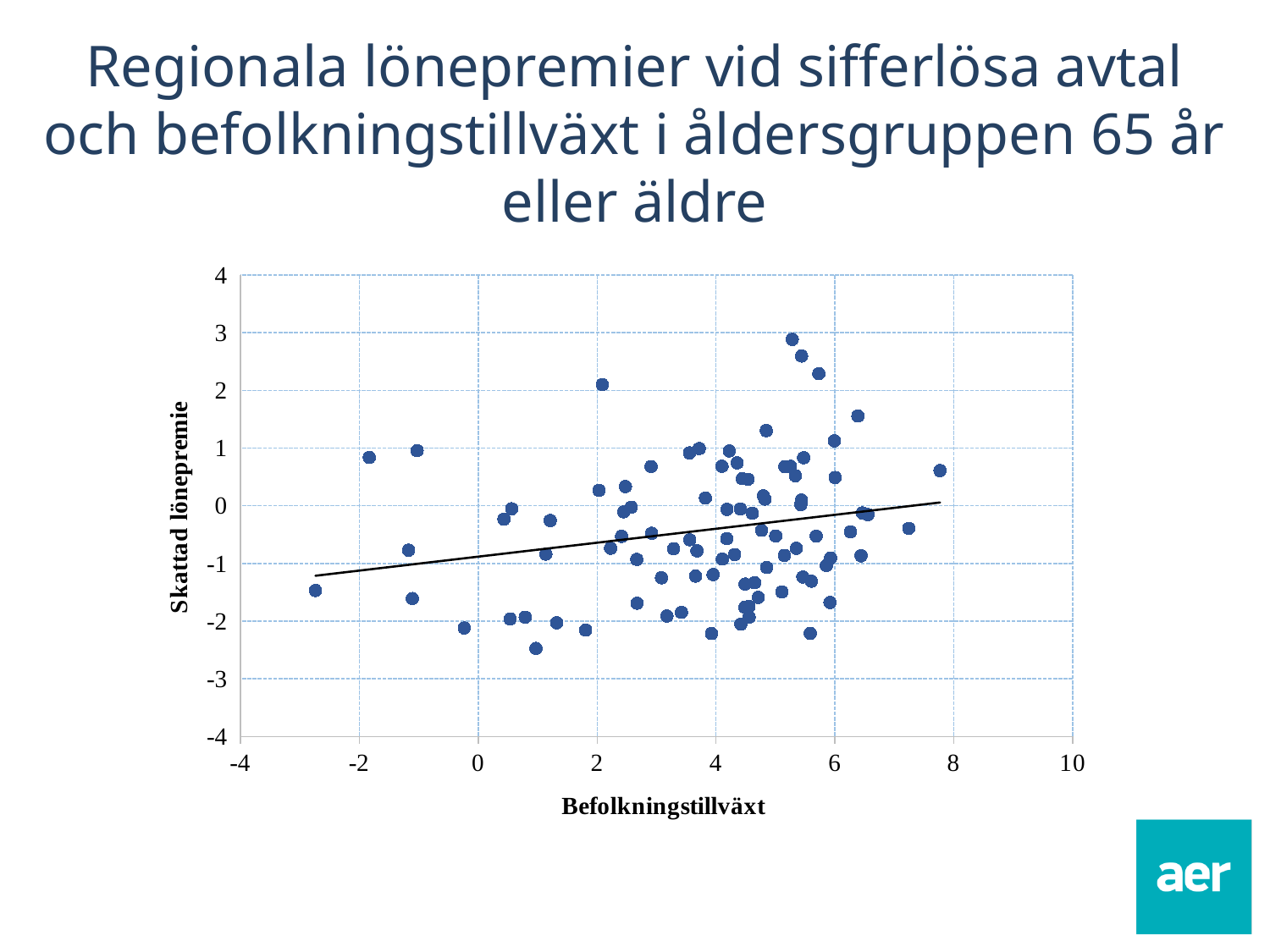
Is the Skattad lönepremie value of the leftmost point greater or less than -1? less What is the title of the vertical axis? Skattad lönepremie Is the Skattad lönepremie value of the lowest point in the chart greater or less than -2? less Is the Skattad lönepremie value of the highest point in the chart greater or less than 2? greater Are there more points with Befolkningstillväxt greater than 2 or less than 2? greater than 2 What is the title of the horizontal axis? Befolkningstillväxt What kind of chart is shown on the slide? scatter chart Does the fitted trend line rise or fall as Befolkningstillväxt increases? rises